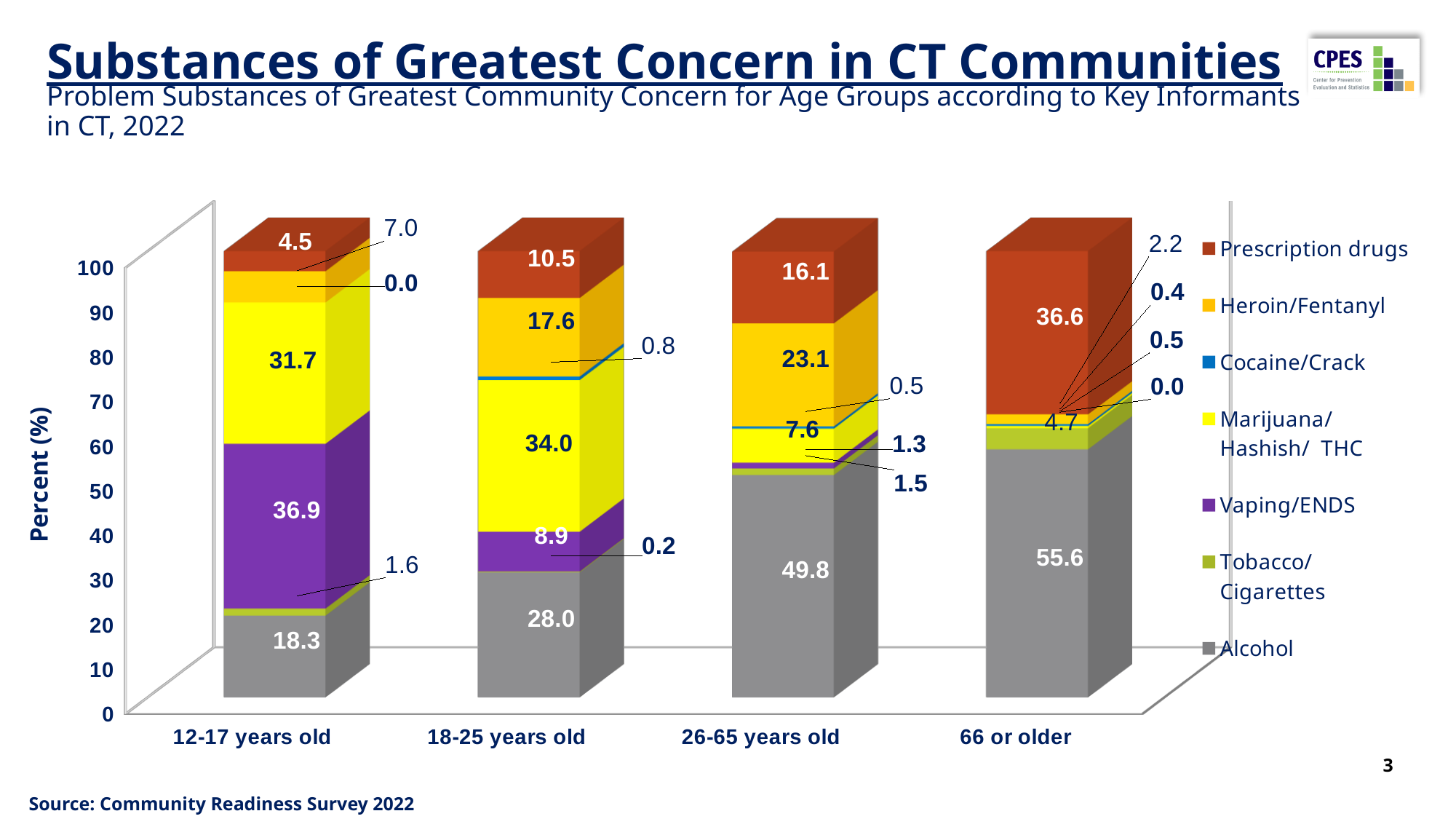
How many age groups are shown on the x axis? 4 What is the value for Vaping/ENDS in the 12-17 years old age group? 36.9 What is the value for Marijuana/Hashish/THC in the 18-25 years old age group? 34.0 What is the value for Alcohol in the 66 or older age group? 55.6 Which age group has the highest value for Alcohol? 66 or older Which age group has the larger Heroin/Fentanyl value, 18-25 years old or 26-65 years old? 26-65 years old Which age group has the lowest value for Alcohol? 12-17 years old Does the Alcohol value rise or fall as the age groups move from 12-17 years old to 66 or older? Rises How many series does the legend list? 7 What kind of chart is shown on the slide? Stacked bar chart What is the value for Prescription drugs in the 26-65 years old age group? 16.1 What is the difference between the Alcohol values for 66 or older and 12-17 years old? 37.3